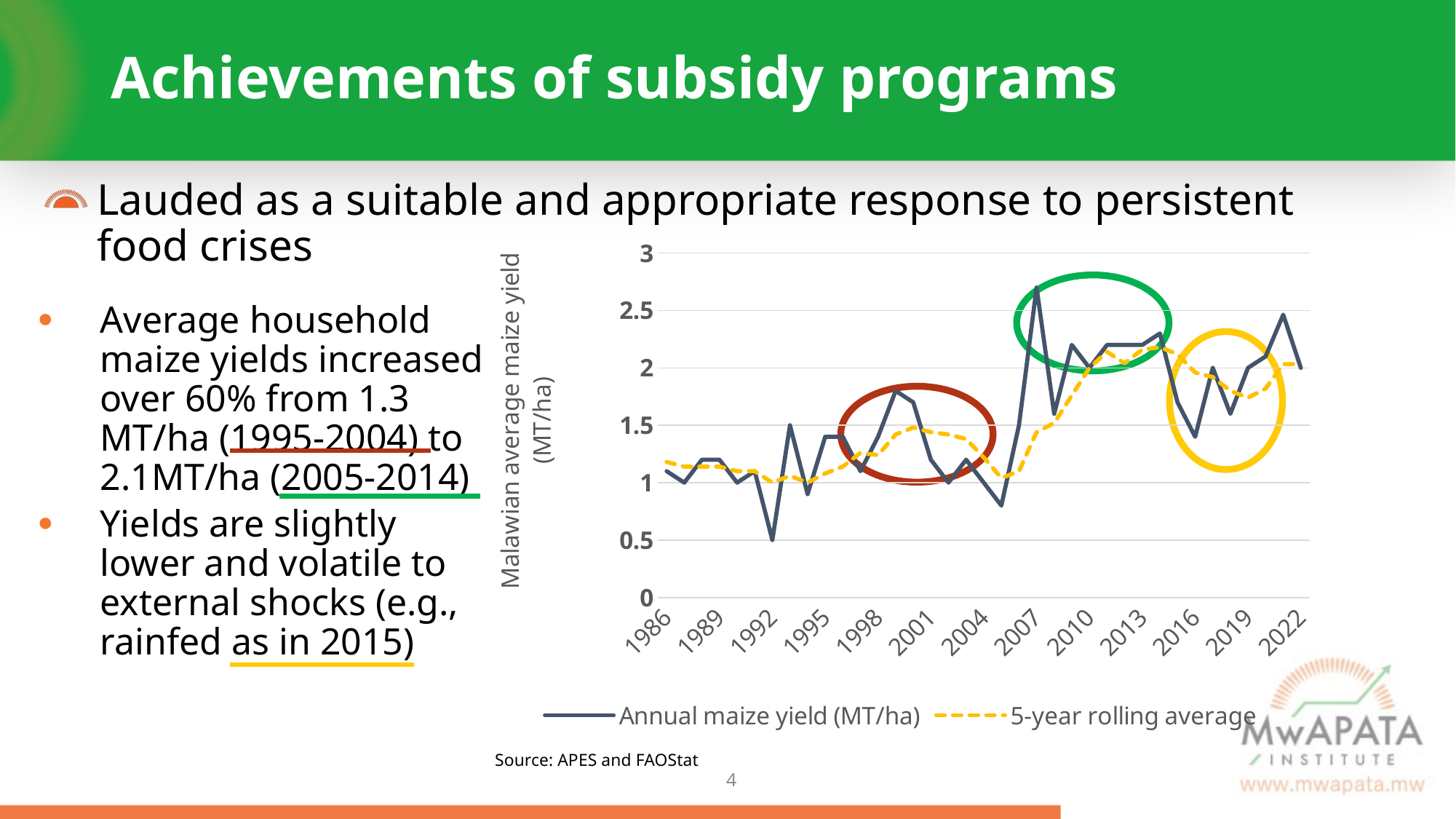
Is the annual maize yield around 1992 greater or less than 1? less How many series does the chart legend list? 2 How many year labels are shown on the chart's x axis? 13 What is the title of the chart's vertical axis? Malawian average maize yield (MT/ha) Is the annual maize yield around 2016 greater or less than 2? less Overall, does the annual maize yield rise or fall from 1986 to 2022? rise What kind of chart is shown on the slide? line chart Around which year does the annual maize yield reach its highest value? 2007 What are the two series named in the chart legend? Annual maize yield (MT/ha) and 5-year rolling average Which is larger, the annual maize yield around 2007 or around 1992? 2007 Is the peak annual maize yield around 2007 greater or less than 2.5? greater Around which year does the annual maize yield reach its lowest value? 1992